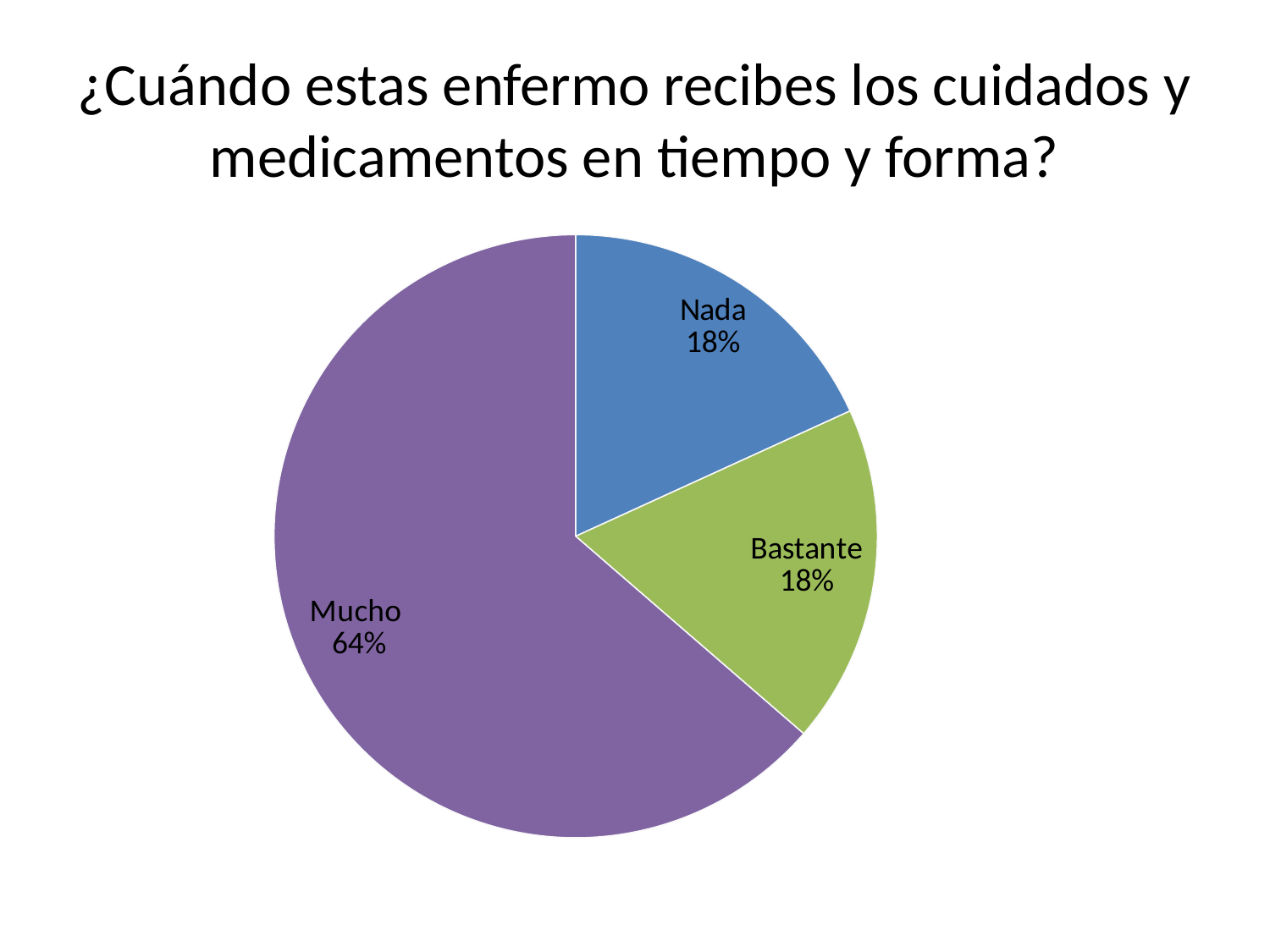
What is the combined share of the Nada and Bastante slices? 36% How many slices does the pie chart have? 3 What colour is the Mucho slice? Purple What is the title of the slide? ¿Cuándo estas enfermo recibes los cuidados y medicamentos en tiempo y forma? Which is larger, the Mucho slice or the Bastante slice? Mucho What share of the pie does the Nada slice represent? 18% What share of the pie does the Mucho slice represent? 64% What share of the pie does the Bastante slice represent? 18% What kind of chart is shown on the slide? Pie chart What is the difference in percentage points between the Mucho slice and the Nada slice? 46 Which category has the largest slice of the pie? Mucho